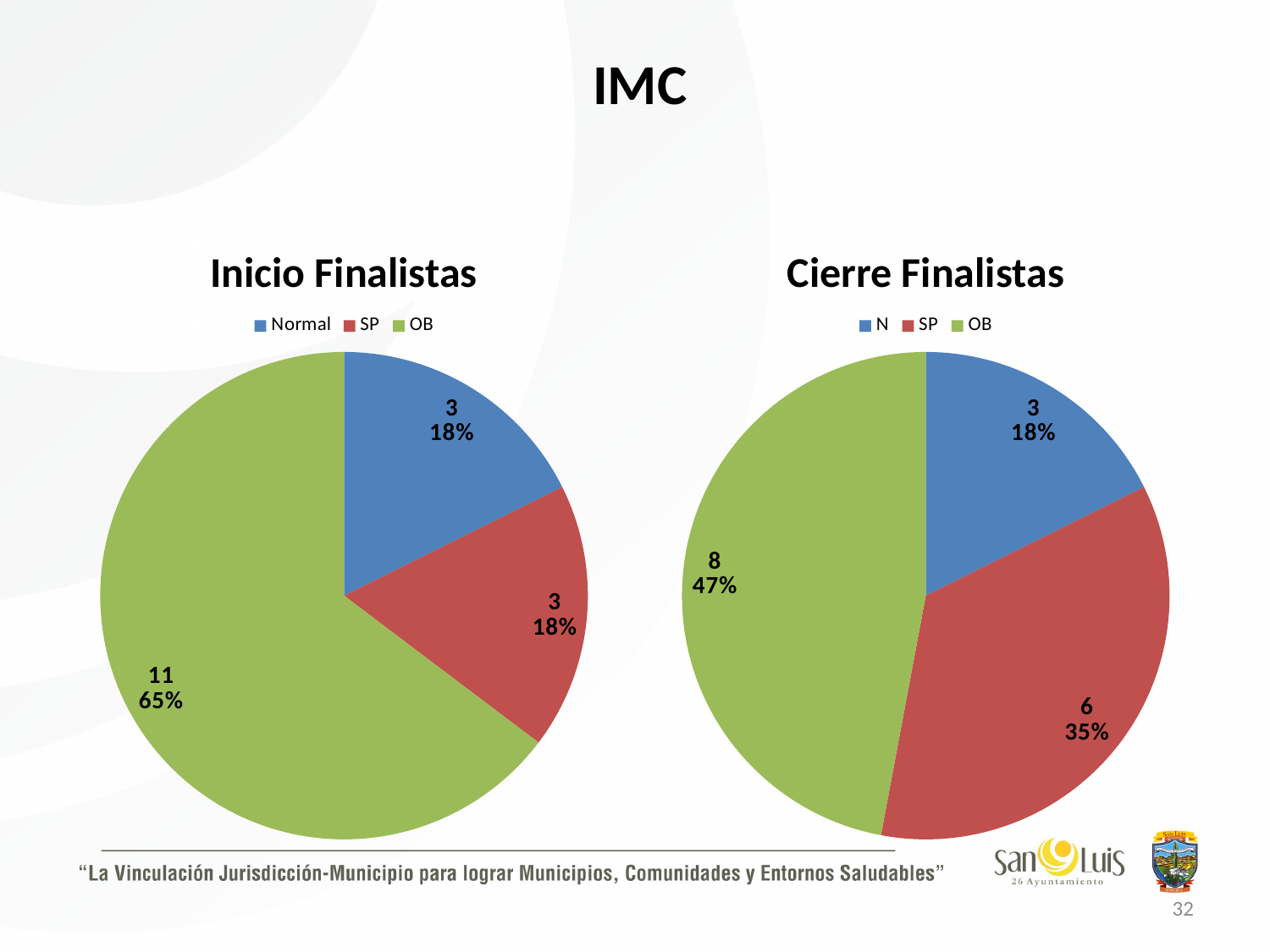
In the "Cierre Finalistas" chart, which category has the largest slice? OB In the "Cierre Finalistas" chart, what is the difference between the OB value and the SP value? 2 In the "Inicio Finalistas" chart, what percentage share does OB have? 65% In the "Inicio Finalistas" chart, what is the value for OB? 11 What type of chart is "Inicio Finalistas"? Pie chart In the "Inicio Finalistas" chart, which category has the largest slice? OB In the "Cierre Finalistas" chart, which is larger, the value for SP or the value for N? SP In the "Inicio Finalistas" chart, what is the difference between the OB value and the Normal value? 8 In the "Cierre Finalistas" chart, what is the value for SP? 6 In the "Cierre Finalistas" chart, which category has the smallest slice? N In the "Cierre Finalistas" chart, what percentage share does OB have? 47% How many series does the legend of the "Cierre Finalistas" chart list? 3